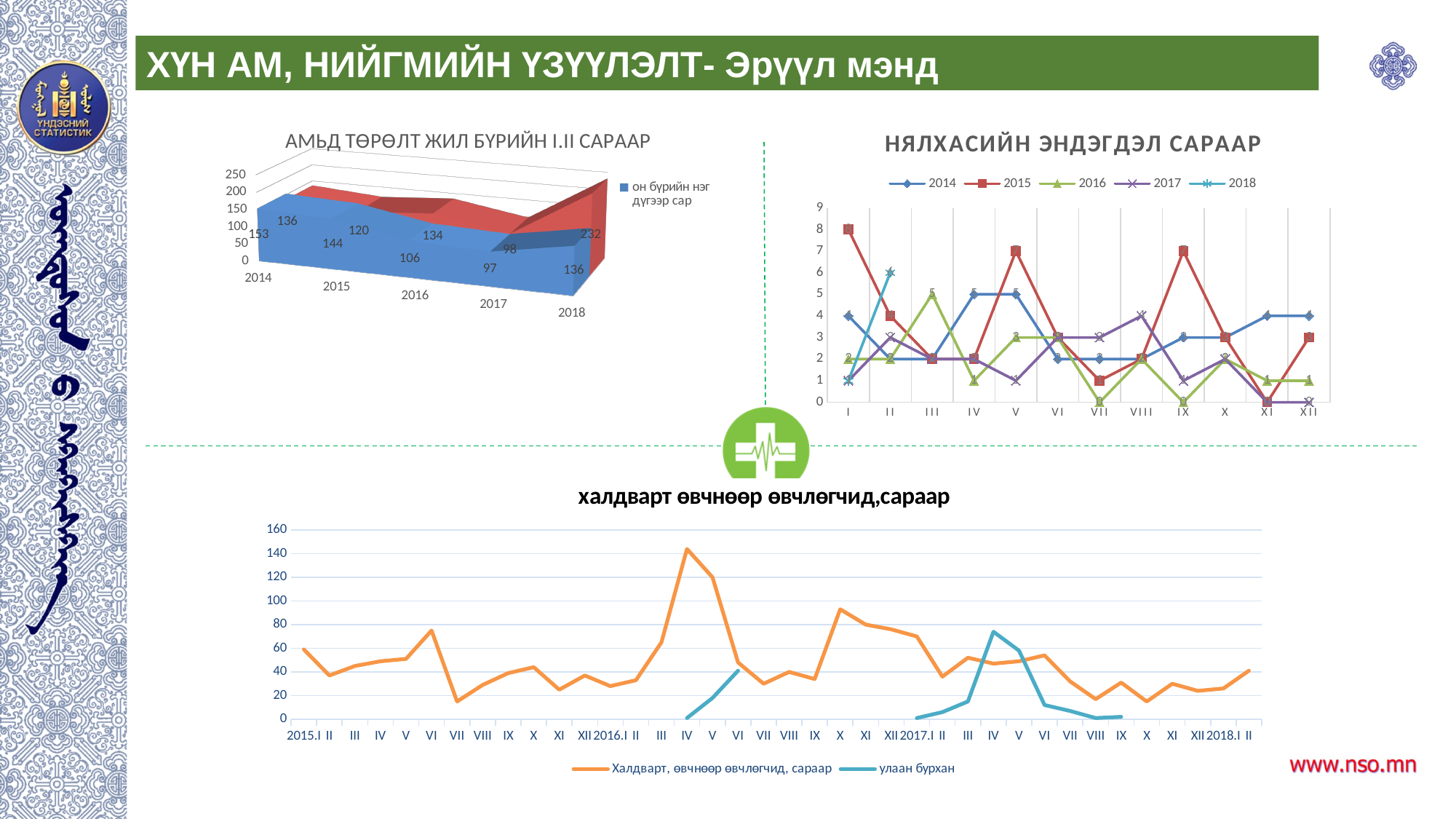
In the bottom chart titled 'халдварт өвчнөөр өвчлөгчид,сараар', what kind of chart is it? line chart In the chart titled 'НЯЛХАСИЙН ЭНДЭГДЭЛ САРААР', what is the value for 2015 in month I? 8 In the chart titled 'АМЬД ТӨРӨЛТ ЖИЛ БҮРИЙН I.II САРААР', how many years are shown on the x axis? 5 In the chart titled 'НЯЛХАСИЙН ЭНДЭГДЭЛ САРААР', what is the difference between the 2015 value and the 2014 value in month I? 4 In the chart titled 'НЯЛХАСИЙН ЭНДЭГДЭЛ САРААР', how many series does the legend list? 5 In the bottom chart titled 'халдварт өвчнөөр өвчлөгчид,сараар', how many series does the legend list? 2 In the chart titled 'НЯЛХАСИЙН ЭНДЭГДЭЛ САРААР', how many months are shown on the x axis? 12 In the bottom chart titled 'халдварт өвчнөөр өвчлөгчид,сараар', is the value of the orange series at 2016.IV greater or less than 120? greater In the chart titled 'НЯЛХАСИЙН ЭНДЭГДЭЛ САРААР', which is larger in month IX: the value for 2015 or the value for 2014? 2015 In the chart titled 'АМЬД ТӨРӨЛТ ЖИЛ БҮРИЙН I.II САРААР', what is the legend entry shown for the blue series? он бүрийн нэг дүгээр сар In the chart titled 'НЯЛХАСИЙН ЭНДЭГДЭЛ САРААР', what is the value for 2018 in month II? 6 In the chart titled 'НЯЛХАСИЙН ЭНДЭГДЭЛ САРААР', in which month is the 2015 series highest? I